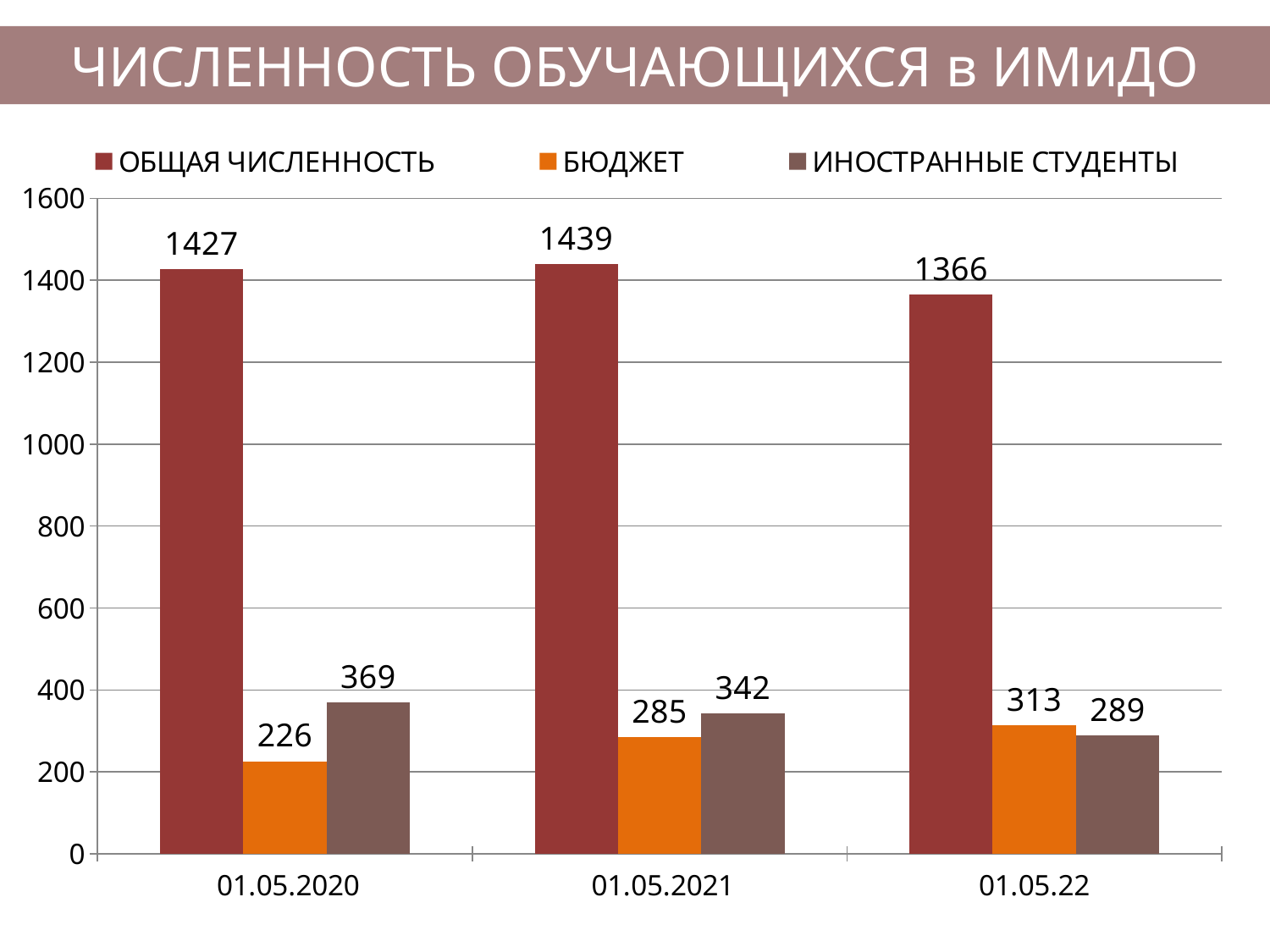
Is the value of ОБЩАЯ ЧИСЛЕННОСТЬ for 01.05.22 greater or less than 1400? less What is the difference between ОБЩАЯ ЧИСЛЕННОСТЬ for 01.05.2021 and for 01.05.22? 73 How many series does the legend list? 3 What kind of chart is shown on the slide? bar chart What is the value of БЮДЖЕТ for 01.05.2020? 226 Which date has the highest value for ОБЩАЯ ЧИСЛЕННОСТЬ? 01.05.2021 Which date has the lowest value for БЮДЖЕТ? 01.05.2020 How many dates are shown on the x axis? 3 Does the value of БЮДЖЕТ rise or fall from 01.05.2020 to 01.05.22? rise What is the value of ИНОСТРАННЫЕ СТУДЕНТЫ for 01.05.22? 289 Which is larger for 01.05.22: БЮДЖЕТ or ИНОСТРАННЫЕ СТУДЕНТЫ? БЮДЖЕТ What is the value of ОБЩАЯ ЧИСЛЕННОСТЬ for 01.05.2021? 1439